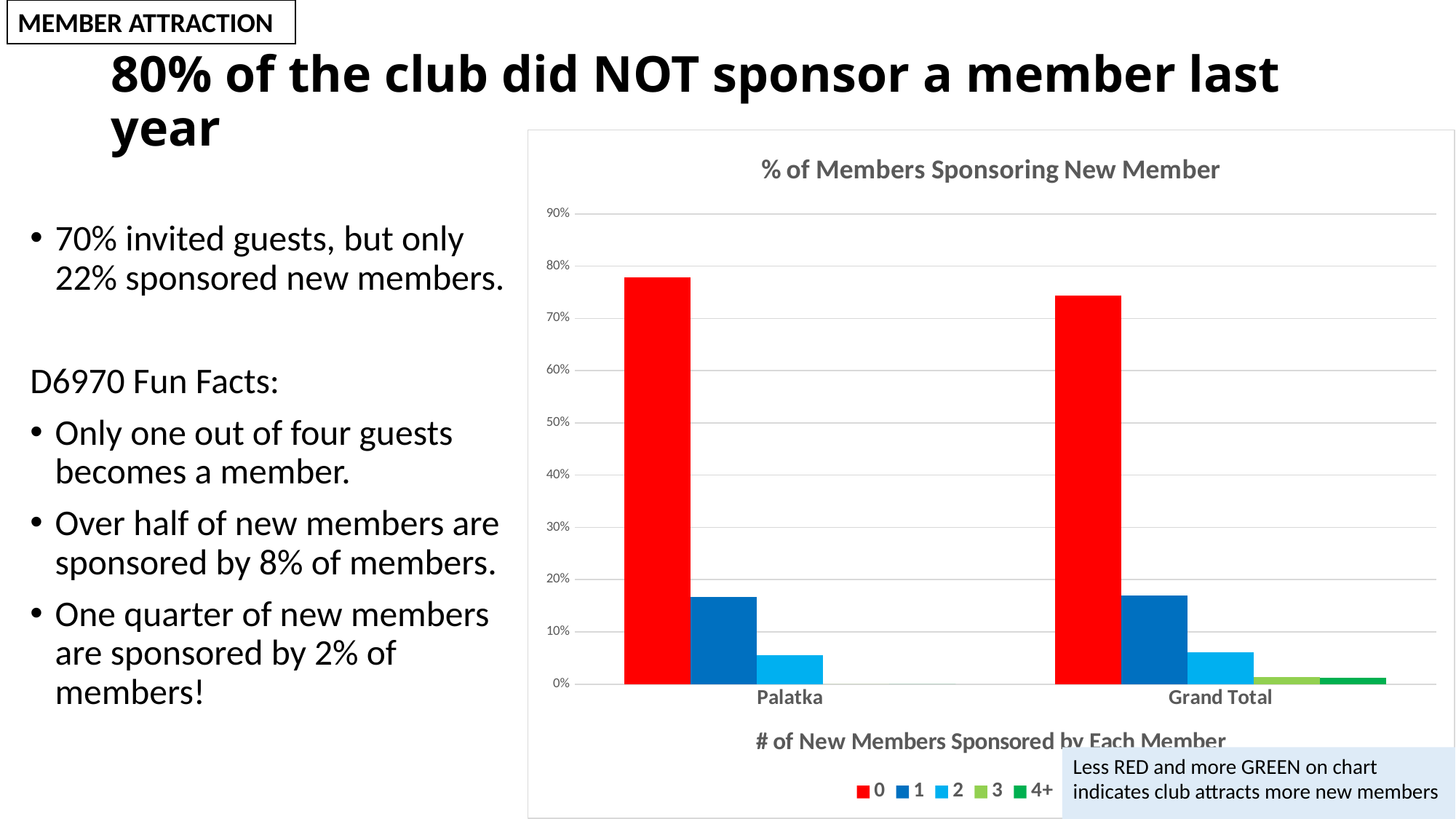
Is the value for series 0 in the Palatka category greater or less than 70%? greater How many series does the chart legend list? 5 Which is larger: the series 0 bar for Palatka or the series 0 bar for Grand Total? Palatka Is the value for series 1 in the Grand Total category greater or less than 20%? less How many categories are shown on the x axis of the chart? 2 What is the x-axis title of the chart? # of New Members Sponsored by Each Member Is the value for series 2 in the Palatka category greater or less than 10%? less Which series has the tallest bar for Palatka? 0 What is the title of the chart? % of Members Sponsoring New Member What kind of chart is shown on the slide? bar chart Which series has the tallest bar for Grand Total? 0 Which is larger for Grand Total: the series 1 bar or the series 2 bar? series 1